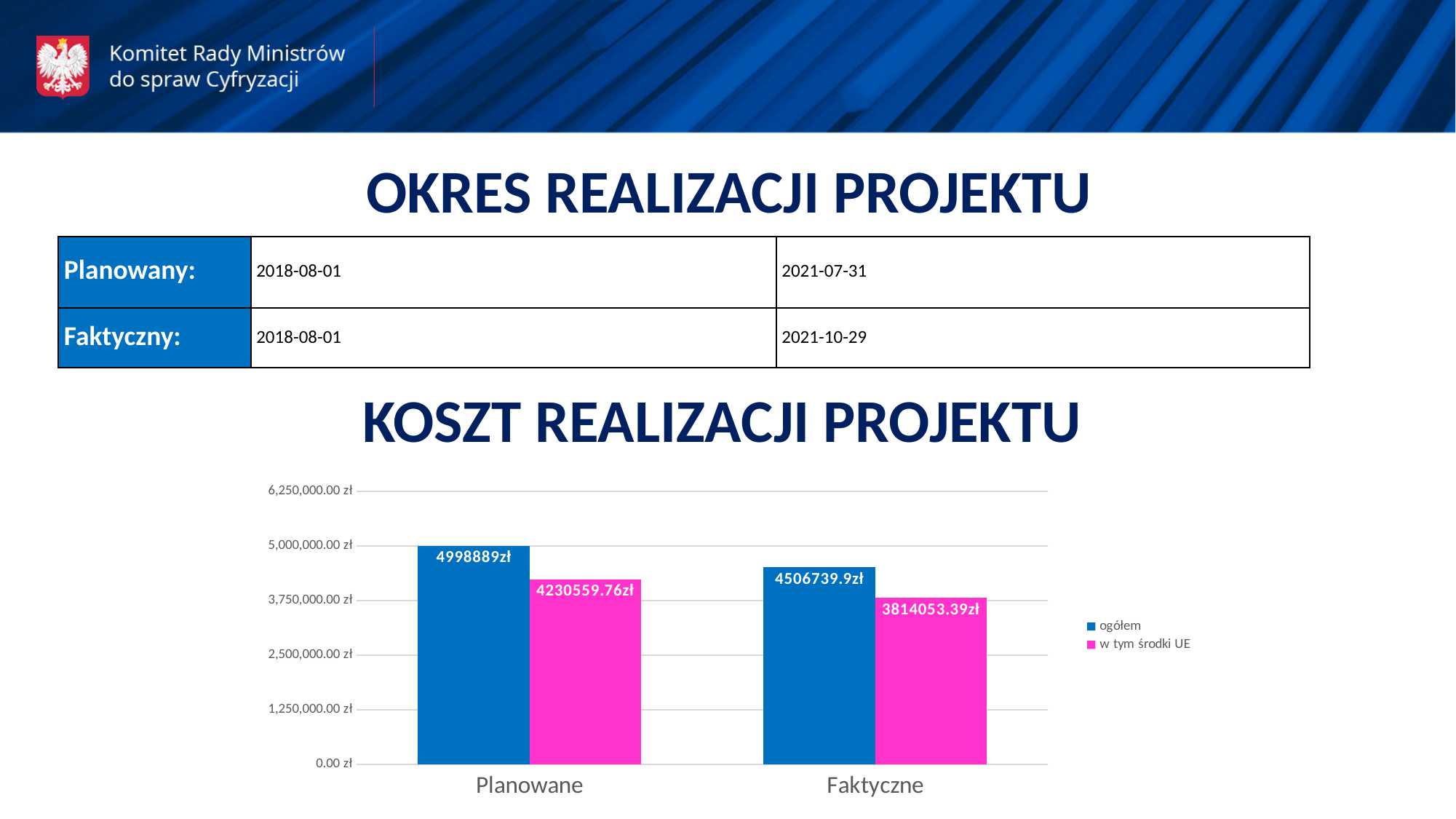
What is the difference between the ogółem and w tym środki UE values for Faktyczne? 692686.51zł How many series does the chart legend list? 2 What type of chart is shown under the title KOSZT REALIZACJI PROJEKTU? bar chart Is the w tym środki UE value for Faktyczne greater or less than 3,750,000.00 zł? greater What is the value of the ogółem bar for Faktyczne? 4506739.9zł What is the difference between the ogółem values for Planowane and Faktyczne? 492149.1zł What is the value of the w tym środki UE bar for Faktyczne? 3814053.39zł Which is larger: the w tym środki UE value for Planowane or the ogółem value for Faktyczne? ogółem value for Faktyczne What is the value of the ogółem bar for Planowane? 4998889zł Which bar in the chart has the lowest value? w tym środki UE for Faktyczne What is the value of the w tym środki UE bar for Planowane? 4230559.76zł Which bar in the chart has the highest value? ogółem for Planowane